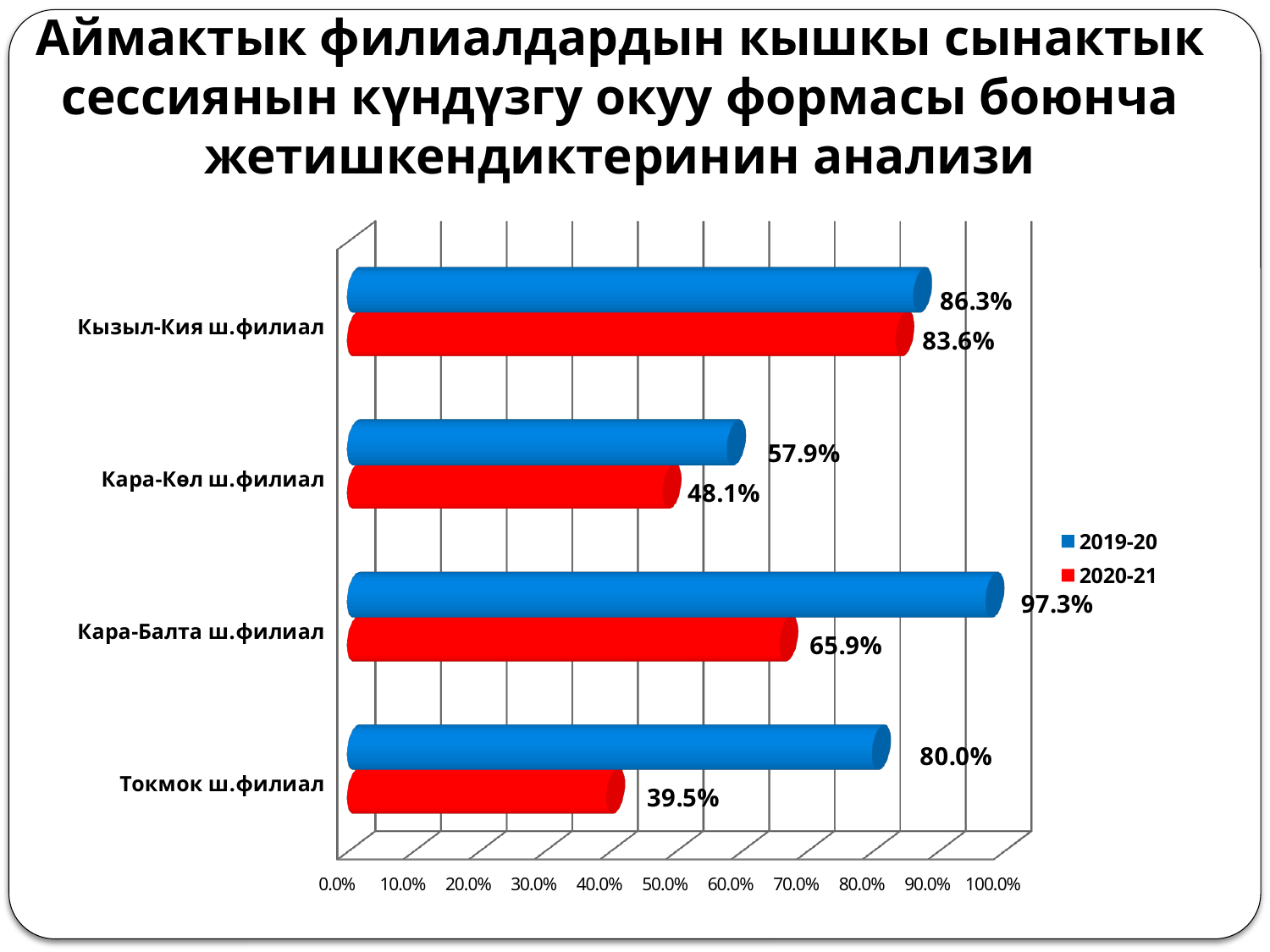
What is the difference between the 2019-20 and 2020-21 values for Кызыл-Кия ш.филиал? 2.7% How many branches are shown on the chart? 4 Which branch has the highest 2019-20 value? Кара-Балта ш.филиал What is the 2020-21 value for Кара-Көл ш.филиал? 48.1% What kind of chart is shown on the slide? bar chart Which branch has the lowest 2020-21 value? Токмок ш.филиал How many series does the legend list? 2 What is the difference between the 2019-20 and 2020-21 values for Токмок ш.филиал? 40.5% Is the 2019-20 value for Кара-Көл ш.филиал greater or less than 50.0%? greater Which is larger: the 2020-21 value for Кара-Балта ш.филиал or the 2020-21 value for Кара-Көл ш.филиал? Кара-Балта ш.филиал What is the 2019-20 value for Кара-Балта ш.филиал? 97.3% What is the 2020-21 value for Токмок ш.филиал? 39.5%